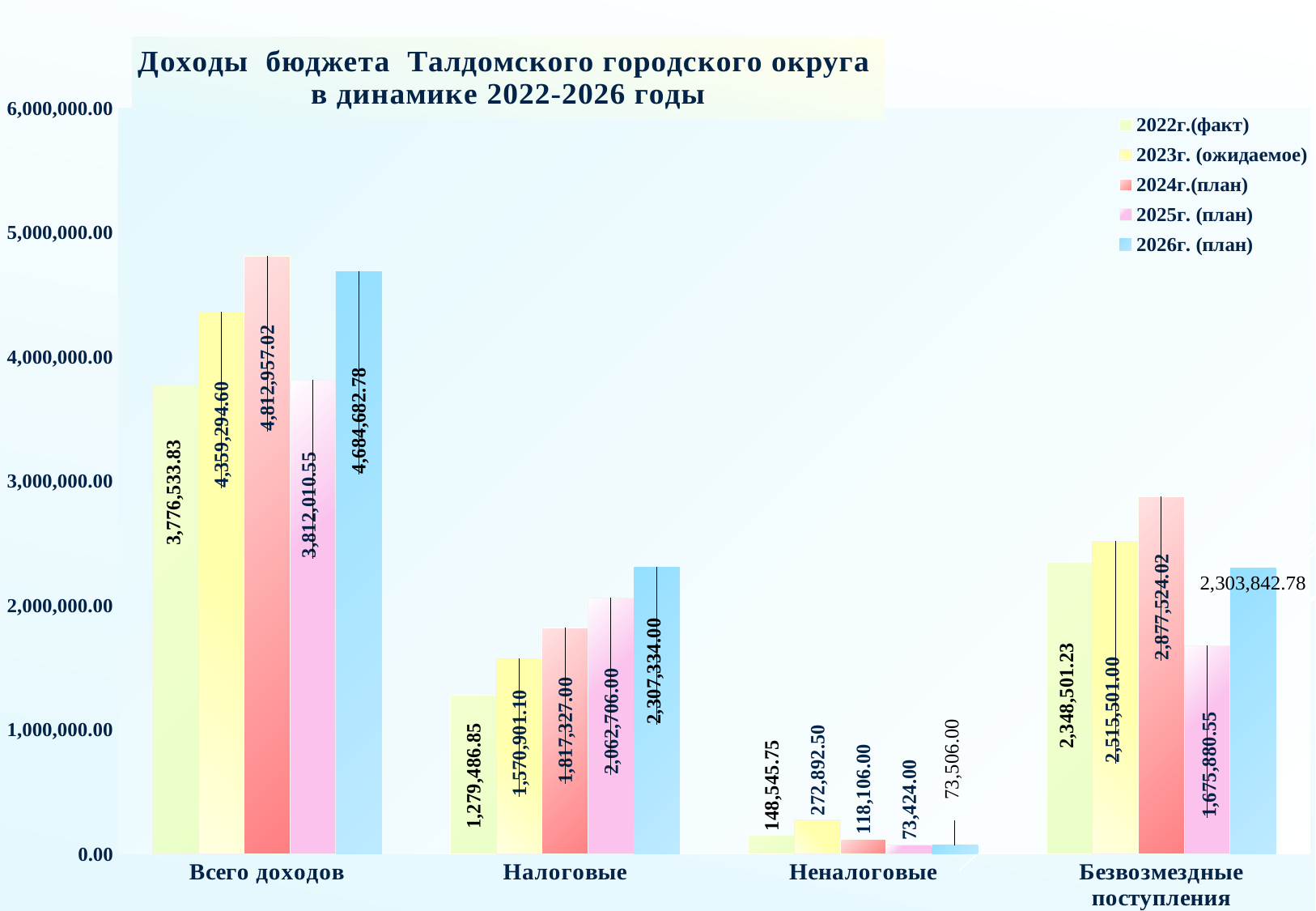
Do the Налоговые values rise or fall from 2022 to 2026? rise Which year has the lowest value in the Налоговые category? 2022г.(факт) How many categories are shown on the x axis? 4 What is the value for 2026г. (план) in the Налоговые category? 2,307,334.00 What is the value for 2025г. (план) in the Безвозмездные поступления category? 1,675,880.55 What is the value for 2024г.(план) in the Всего доходов category? 4,812,957.02 Which is larger in the Безвозмездные поступления category: the 2023г. (ожидаемое) value or the 2026г. (план) value? 2023г. (ожидаемое) What is the difference between the 2026г. (план) and 2022г.(факт) values in the Налоговые category? 1,027,847.15 What kind of chart is shown on the slide? bar chart How many series does the legend list? 5 Which year has the highest value in the Всего доходов category? 2024г.(план) What is the value for 2023г. (ожидаемое) in the Неналоговые category? 272,892.50